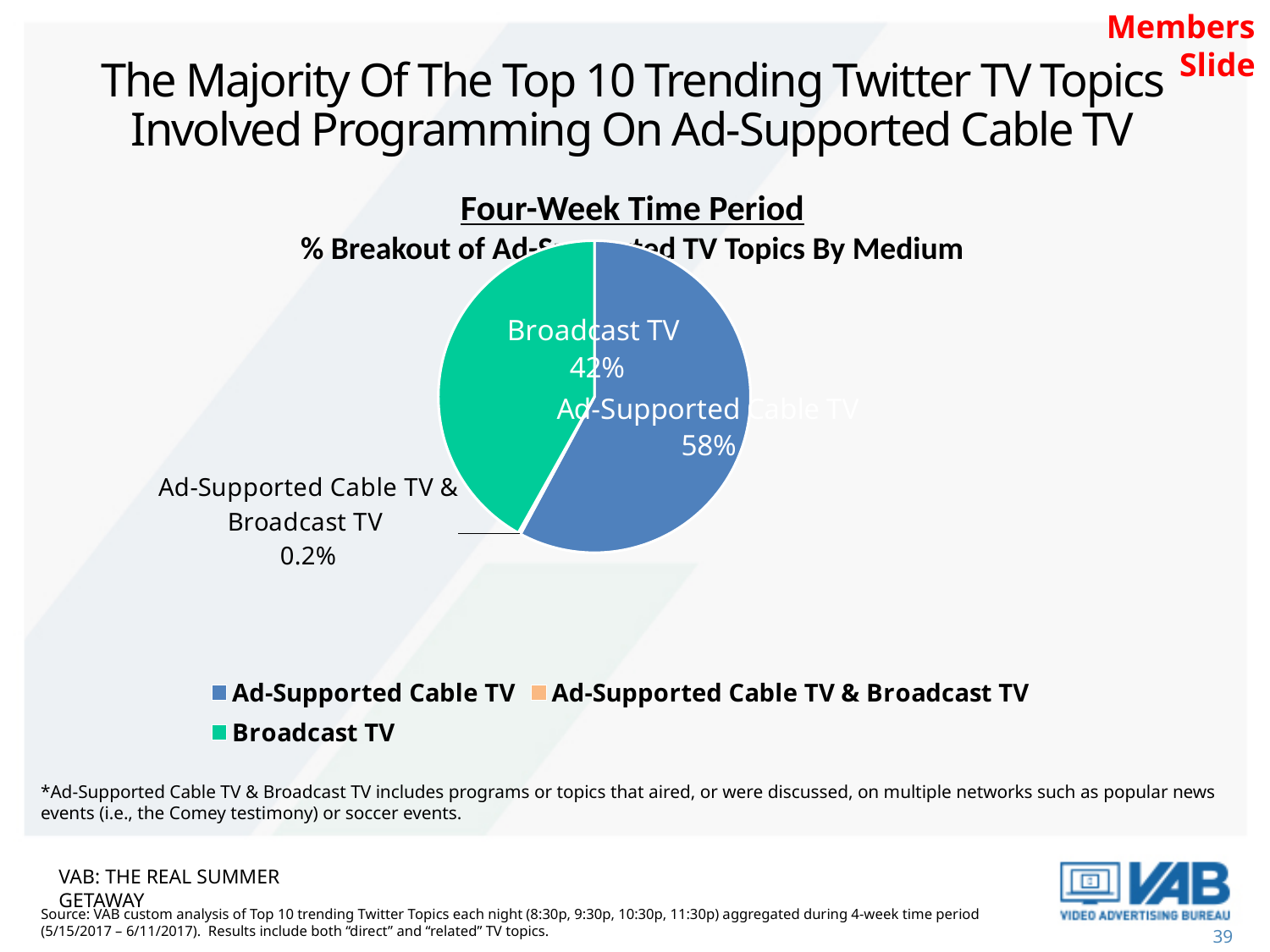
How many slices does the pie chart have? 3 What share of the pie does Ad-Supported Cable TV hold? 58% How many entries does the legend list? 3 What kind of chart is shown on the slide? pie chart What is the value shown for Ad-Supported Cable TV & Broadcast TV? 0.2% Which is larger, the share for Broadcast TV or the share for Ad-Supported Cable TV? Ad-Supported Cable TV Which medium has the smallest slice of the pie? Ad-Supported Cable TV & Broadcast TV Which medium has the largest slice of the pie? Ad-Supported Cable TV What time period is named in the underlined heading above the chart? Four-Week Time Period What colour is the Broadcast TV slice in the pie chart? green What share of the pie does Broadcast TV hold? 42% What is the difference in percentage points between Ad-Supported Cable TV and Broadcast TV? 16 percentage points